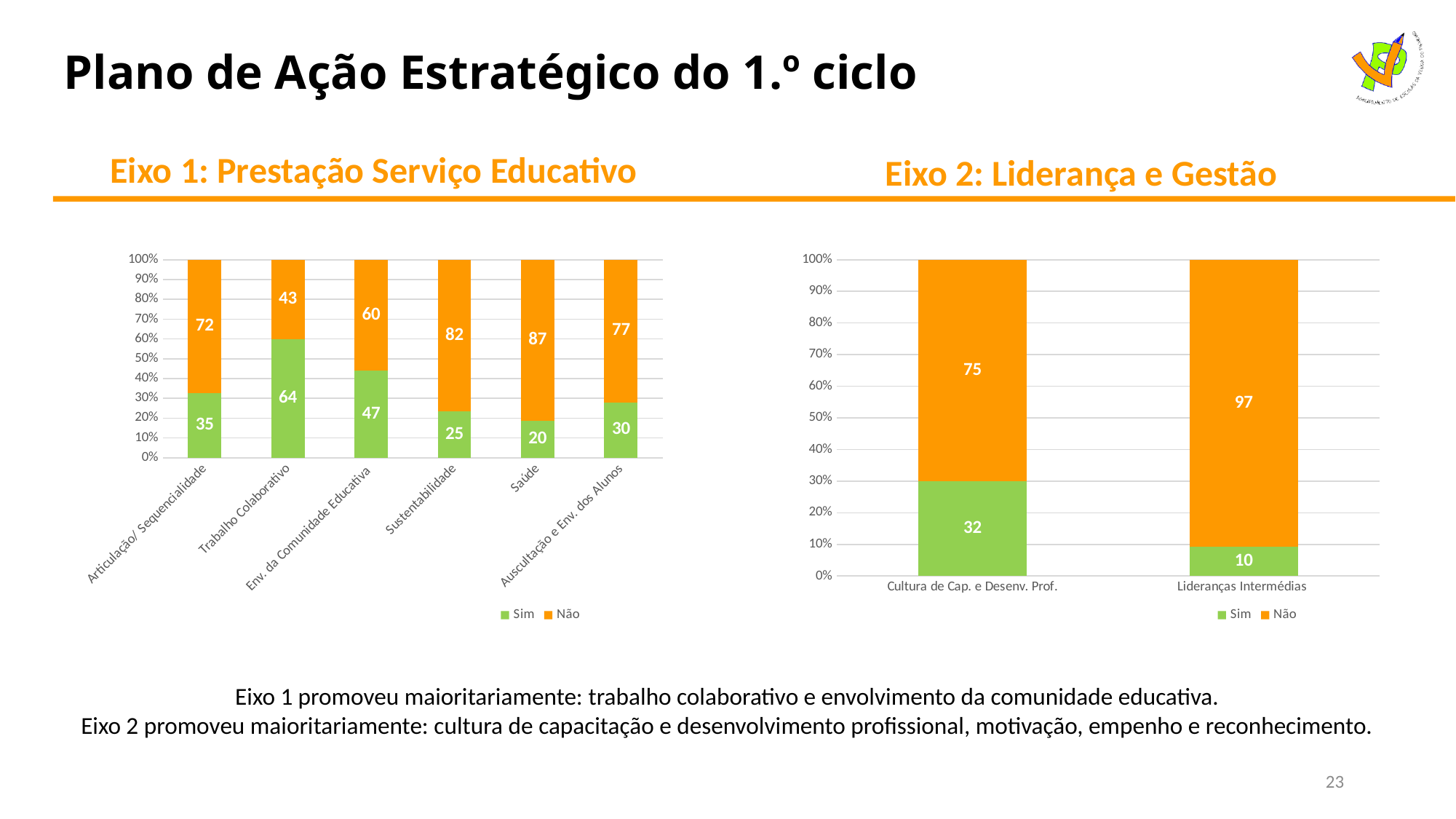
In the Eixo 1: Prestação Serviço Educativo chart, how many categories are shown on the x axis? 6 In the Eixo 2: Liderança e Gestão chart, what is the Sim value for Cultura de Cap. e Desenv. Prof.? 32 In the Eixo 2: Liderança e Gestão chart, which category has the larger Sim value, Cultura de Cap. e Desenv. Prof. or Lideranças Intermédias? Cultura de Cap. e Desenv. Prof. In the Eixo 1: Prestação Serviço Educativo chart, what is the Não value for Saúde? 87 In the Eixo 1: Prestação Serviço Educativo chart, what is the total of the Sim and Não values for Articulação/ Sequencialidade? 107 What type of chart is the Eixo 2: Liderança e Gestão chart? Stacked bar chart In the Eixo 1: Prestação Serviço Educativo chart, which category has the lowest Sim value? Saúde In the Eixo 1: Prestação Serviço Educativo chart, what is the Sim value for Trabalho Colaborativo? 64 In the Eixo 1: Prestação Serviço Educativo chart, which category has the highest Sim value? Trabalho Colaborativo In the Eixo 2: Liderança e Gestão chart, how many series does the legend list? 2 In the Eixo 1: Prestação Serviço Educativo chart, what is the difference between the Não and Sim values for Sustentabilidade? 57 In the Eixo 2: Liderança e Gestão chart, what is the Não value for Lideranças Intermédias? 97